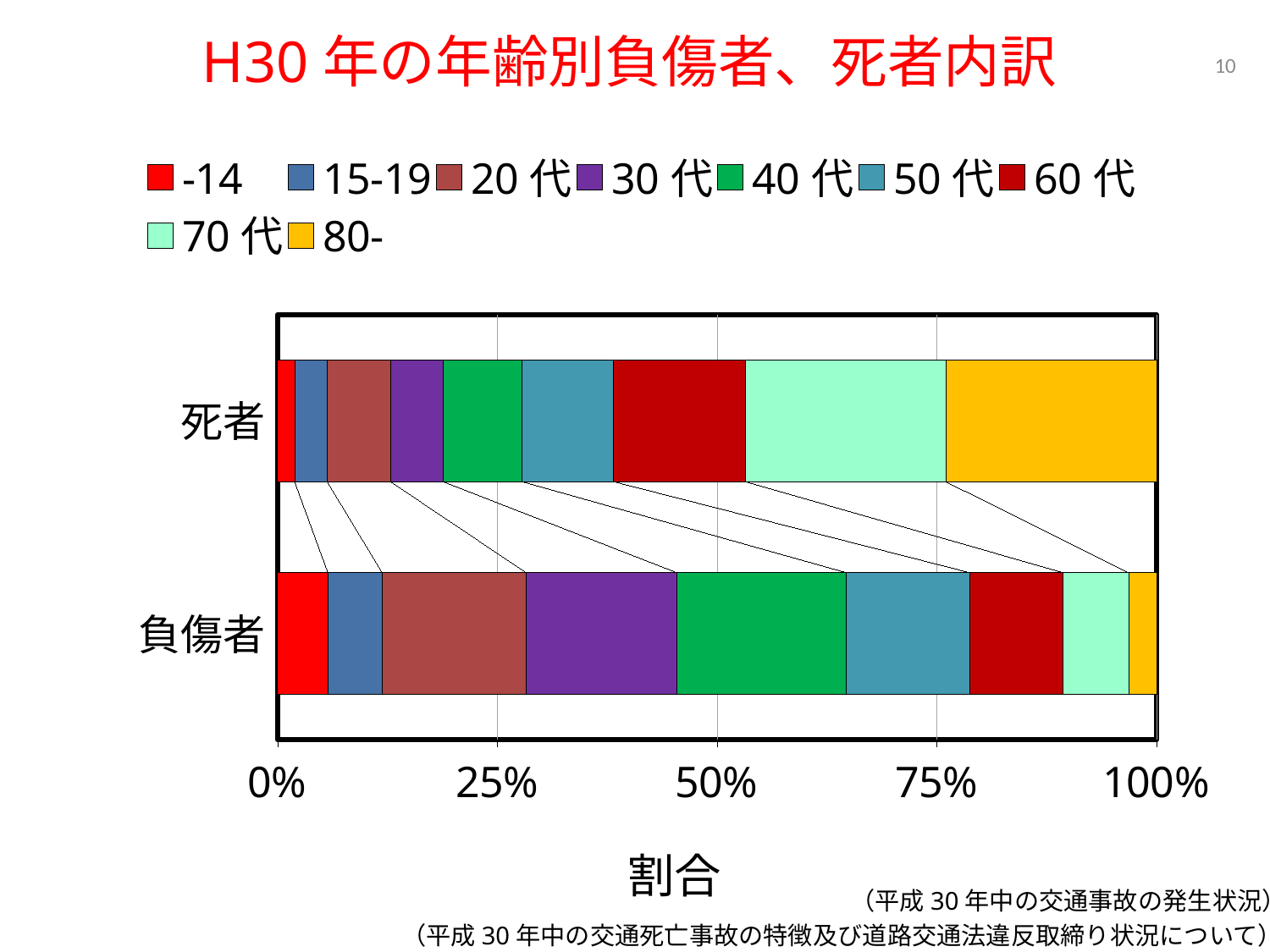
What is the title of the chart on the slide? H30年の年齢別負傷者、死者内訳 How many categories (bars) does the chart show? 2 What kind of chart is shown on the slide? Stacked bar chart Which age group has the smallest segment in the 死者 bar? -14 In the 負傷者 bar, is the cumulative share up to and including 40代 greater or less than 50%? greater In the 死者 bar, is the cumulative share up to and including 50代 greater or less than 50%? less How many series does the legend list? 9 Which age group has the smallest segment in the 負傷者 bar? 80- Is the -14 segment larger in the 死者 bar or the 負傷者 bar? 負傷者 Is the 30代 segment larger in the 死者 bar or the 負傷者 bar? 負傷者 Is the 80- segment larger in the 死者 bar or the 負傷者 bar? 死者 What is the label of the horizontal axis? 割合